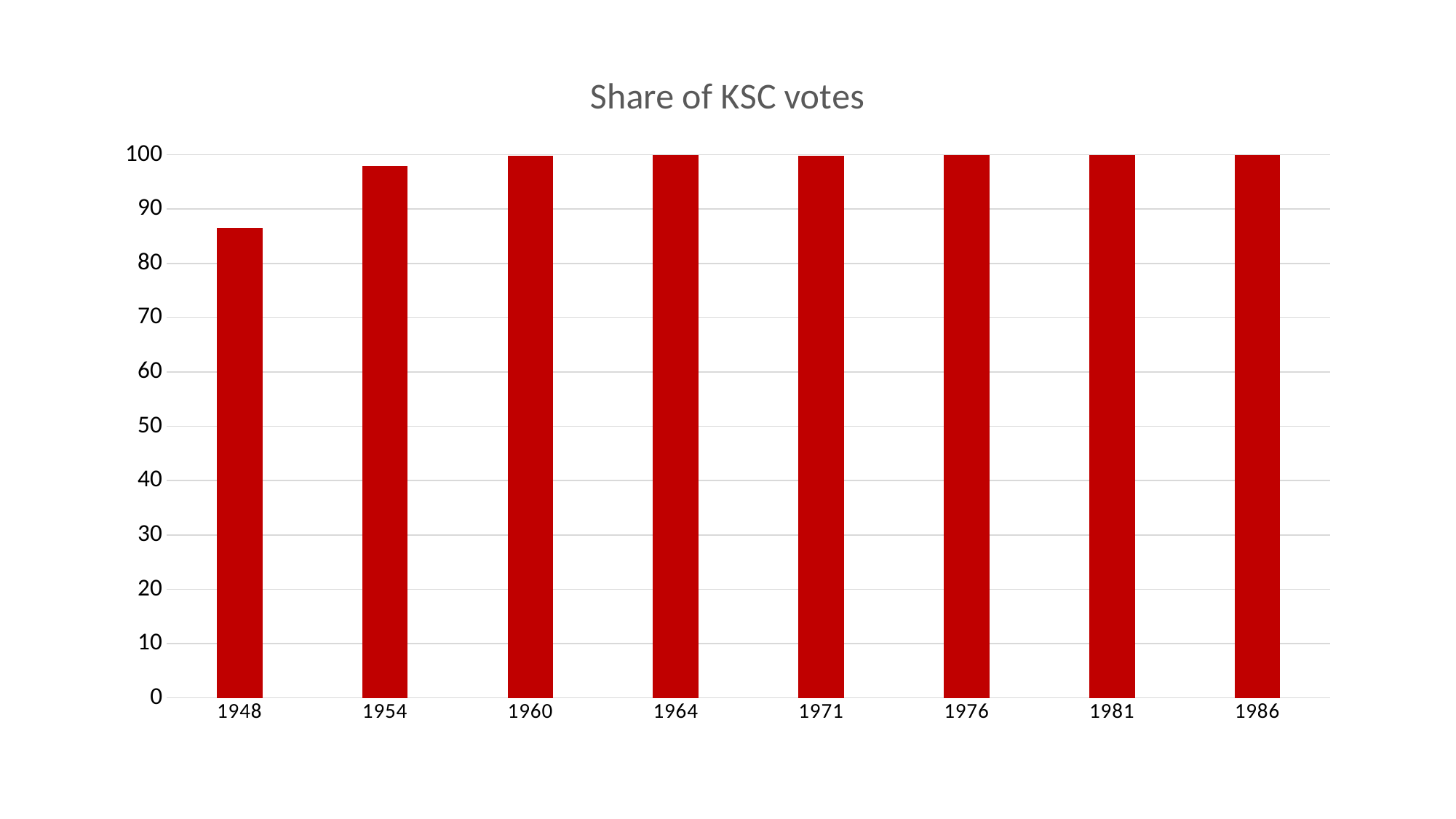
Which is larger, the value for 1948 or the value for 1954? 1954 Do the values generally rise or fall from 1948 to 1986? rise What kind of chart is shown on the slide? bar chart Is the value for 1948 greater or less than 90? less Is the value for 1948 greater or less than 80? greater What is the title of the chart? Share of KSC votes Is the value for 1954 greater or less than 90? greater How many years are shown on the x axis of the chart? 8 Which is larger, the value for 1948 or the value for 1986? 1986 What colour are the bars in the chart? red Which year has the lowest share of KSC votes? 1948